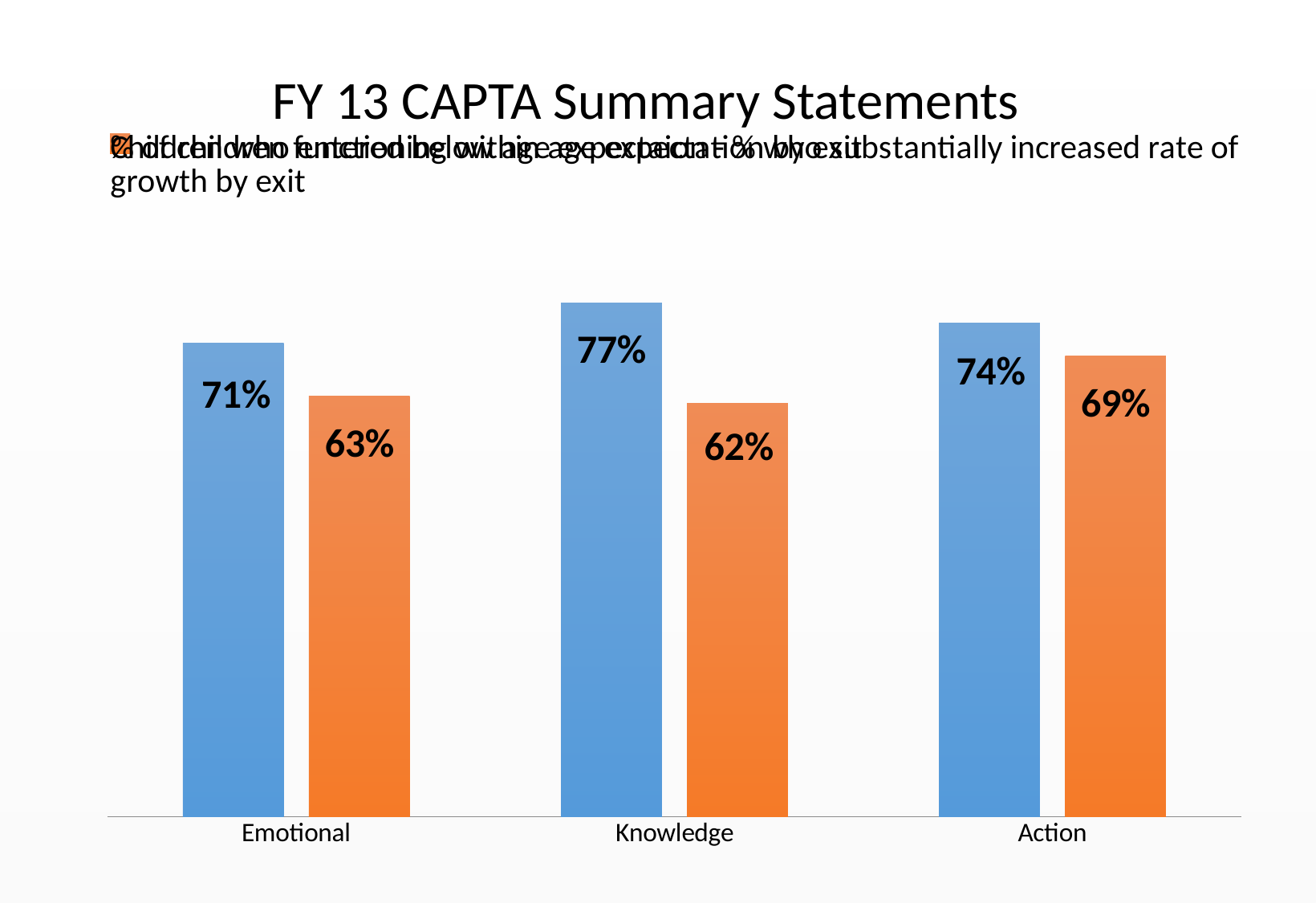
Which is larger for Emotional, the blue bar or the orange bar? the blue bar What is the value of the blue bar for Action? 74% What is the title of the chart? FY 13 CAPTA Summary Statements What is the value of the blue bar for Emotional? 71% What is the value of the orange bar for Action? 69% Which category has the highest blue bar? Knowledge What is the difference between the blue and orange bars for Knowledge? 15% Which category has the lowest orange bar? Knowledge What is the value of the orange bar for Knowledge? 62% What kind of chart is shown on the slide? bar chart What is the difference between the blue and orange bars for Action? 5% How many categories are shown on the x axis? 3